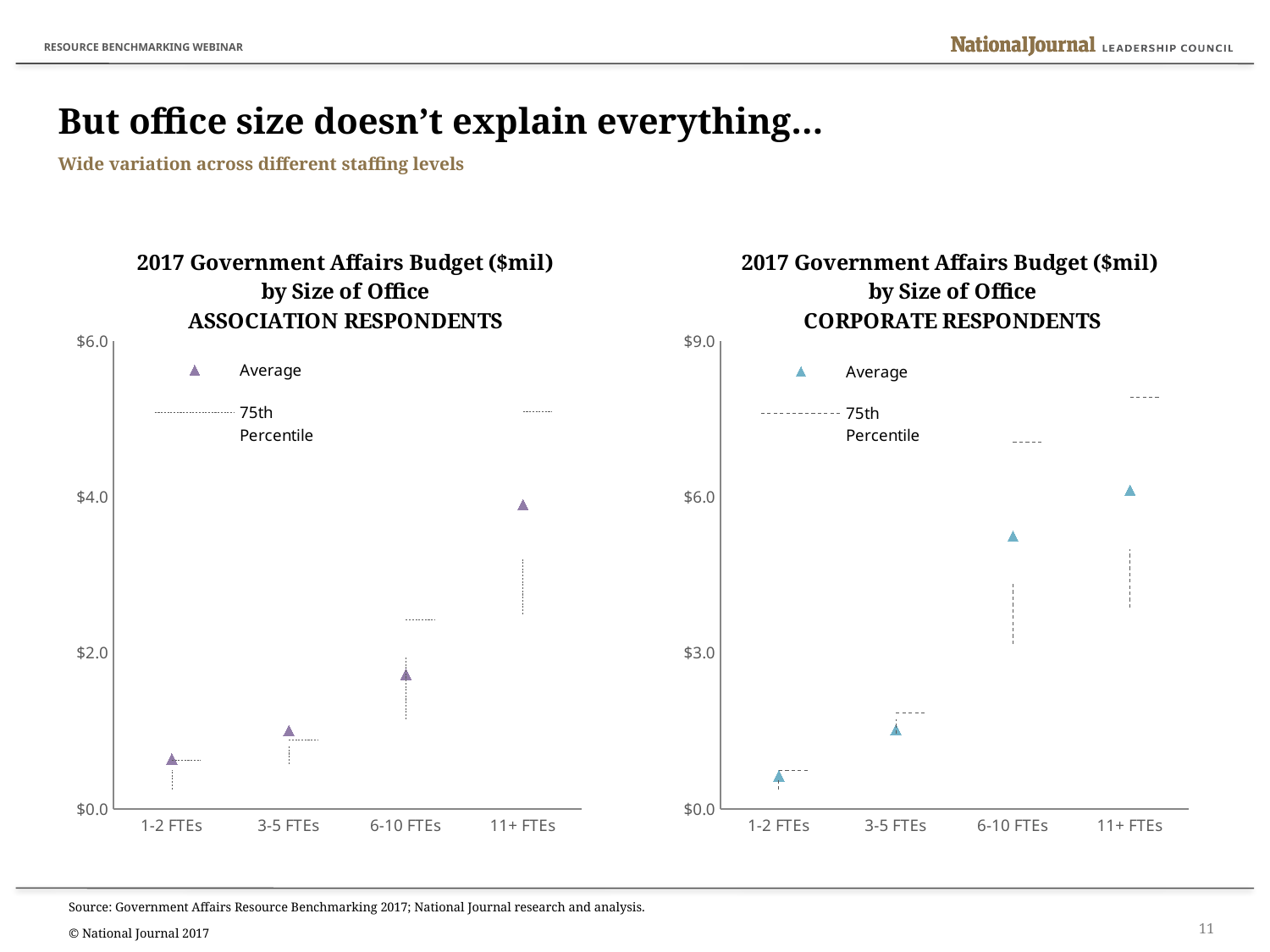
In the CORPORATE RESPONDENTS chart, is the average budget for 6-10 FTEs greater or less than $3.0? greater In the CORPORATE RESPONDENTS chart, which has the larger average budget: 3-5 FTEs or 6-10 FTEs? 6-10 FTEs In the ASSOCIATION RESPONDENTS chart, which office size has the lowest average budget? 1-2 FTEs In the CORPORATE RESPONDENTS chart, is the 75th percentile value for 11+ FTEs greater or less than $9.0? less In the ASSOCIATION RESPONDENTS chart, is the average budget for 11+ FTEs greater or less than $2.0? greater In the CORPORATE RESPONDENTS chart, do the average budget values rise or fall as office size increases along the x axis? rise In the CORPORATE RESPONDENTS chart, which office size has the highest average budget? 11+ FTEs How many office size categories are shown on the x axis of the ASSOCIATION RESPONDENTS chart? 4 How many series does the legend of the CORPORATE RESPONDENTS chart list? 2 What are the two legend entries in the ASSOCIATION RESPONDENTS chart? Average and 75th Percentile In the ASSOCIATION RESPONDENTS chart, which office size has the highest average 2017 Government Affairs budget? 11+ FTEs